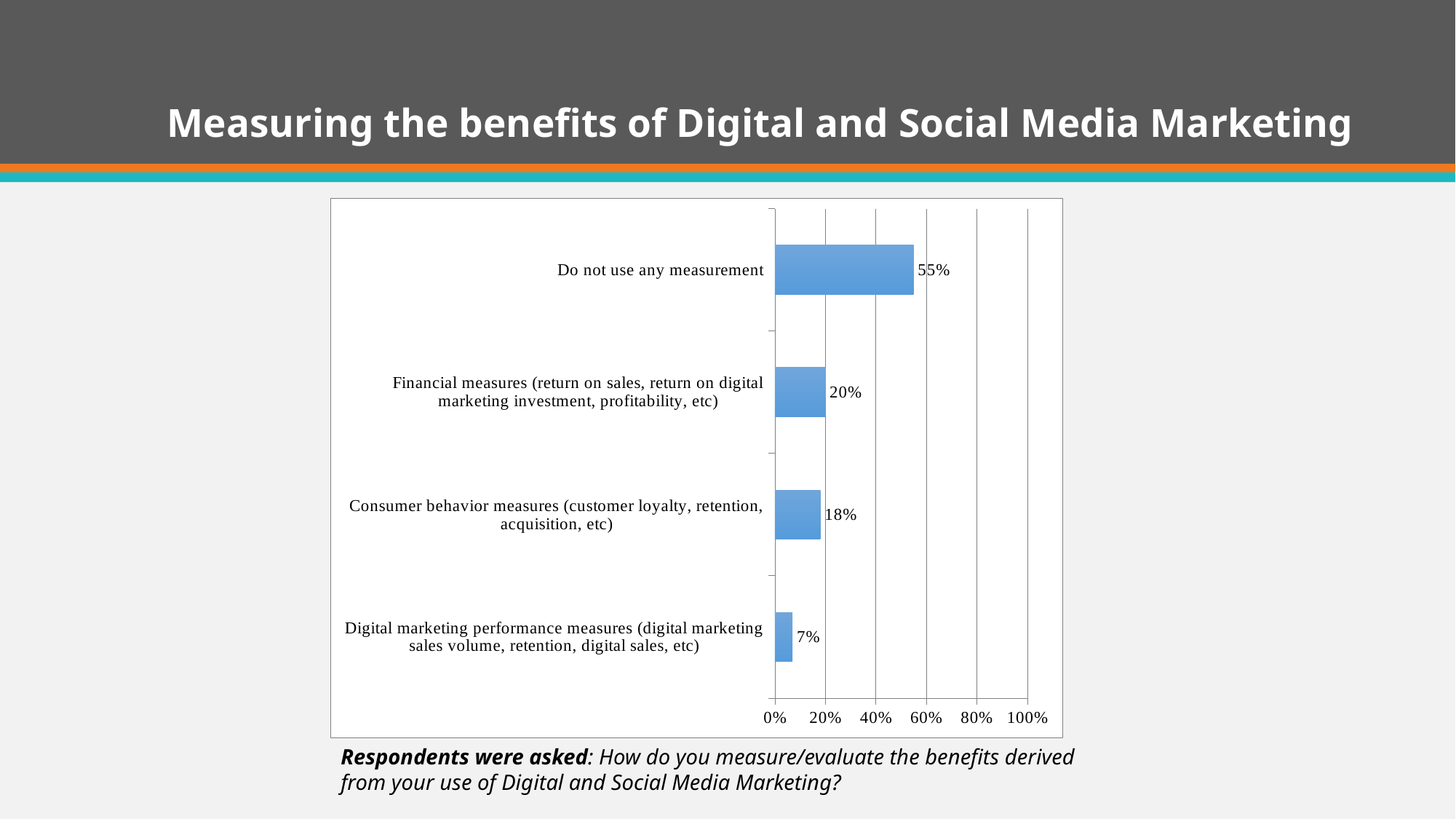
How many categories are shown in the chart? 4 What is the value for Consumer behavior measures? 18% What kind of chart is shown on the slide? Bar chart What is the difference between the values for Do not use any measurement and Financial measures? 35% What is the difference between the values for Consumer behavior measures and Digital marketing performance measures? 11% Is the value for Do not use any measurement greater or less than 40%? greater Which category has the lowest value? Digital marketing performance measures What is the value for Financial measures? 20% What is the value for Digital marketing performance measures? 7% What percentage of respondents do not use any measurement? 55% Which category has the highest value? Do not use any measurement Which is larger, the value for Financial measures or the value for Digital marketing performance measures? Financial measures